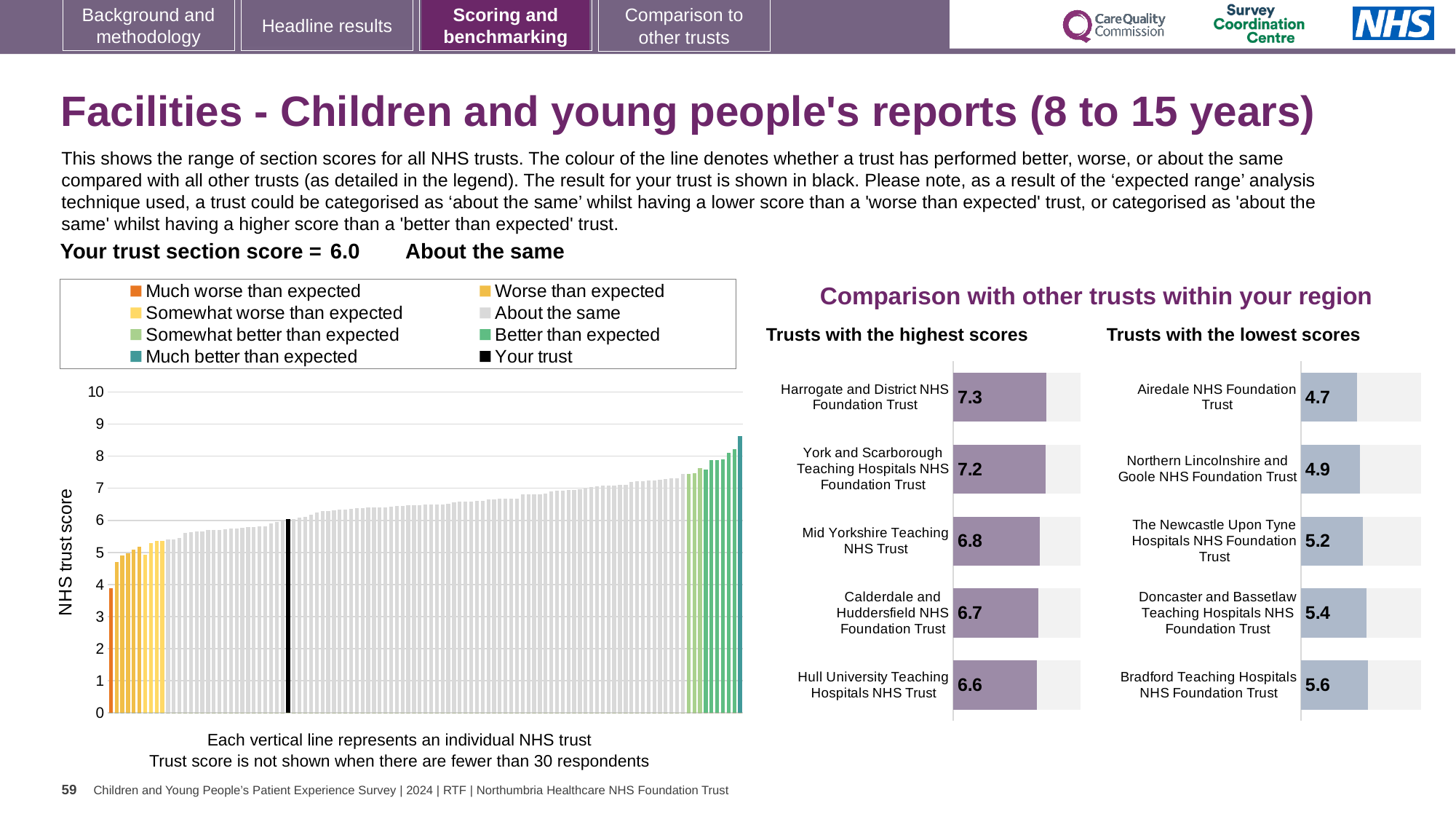
In the main 'NHS trust score' chart on the left, is the value of the tallest bar greater or less than 8? greater How many entries does the legend of the main 'NHS trust score' chart list? 8 Which has a higher score: York and Scarborough Teaching Hospitals NHS Foundation Trust in the highest scores chart, or Doncaster and Bassetlaw Teaching Hospitals NHS Foundation Trust in the lowest scores chart? York and Scarborough Teaching Hospitals NHS Foundation Trust In the main 'NHS trust score' chart on the left, what is the score of the black bar representing your trust? 6.0 In the 'Trusts with the lowest scores' chart, what is the score for Airedale NHS Foundation Trust? 4.7 In the 'Trusts with the highest scores' chart, what is the score for Mid Yorkshire Teaching NHS Trust? 6.8 In the 'Trusts with the highest scores' chart, what is the difference between the scores of Harrogate and District NHS Foundation Trust and Hull University Teaching Hospitals NHS Trust? 0.7 In the 'Trusts with the highest scores' chart, which trust has the lowest score? Hull University Teaching Hospitals NHS Trust In the 'Trusts with the lowest scores' chart, what is the difference between the scores of Bradford Teaching Hospitals NHS Foundation Trust and Airedale NHS Foundation Trust? 0.9 In the 'Trusts with the lowest scores' chart, which trust has the highest score? Bradford Teaching Hospitals NHS Foundation Trust In the 'Trusts with the highest scores' chart, what is the score for Harrogate and District NHS Foundation Trust? 7.3 How many trusts are shown in the 'Trusts with the lowest scores' chart? 5